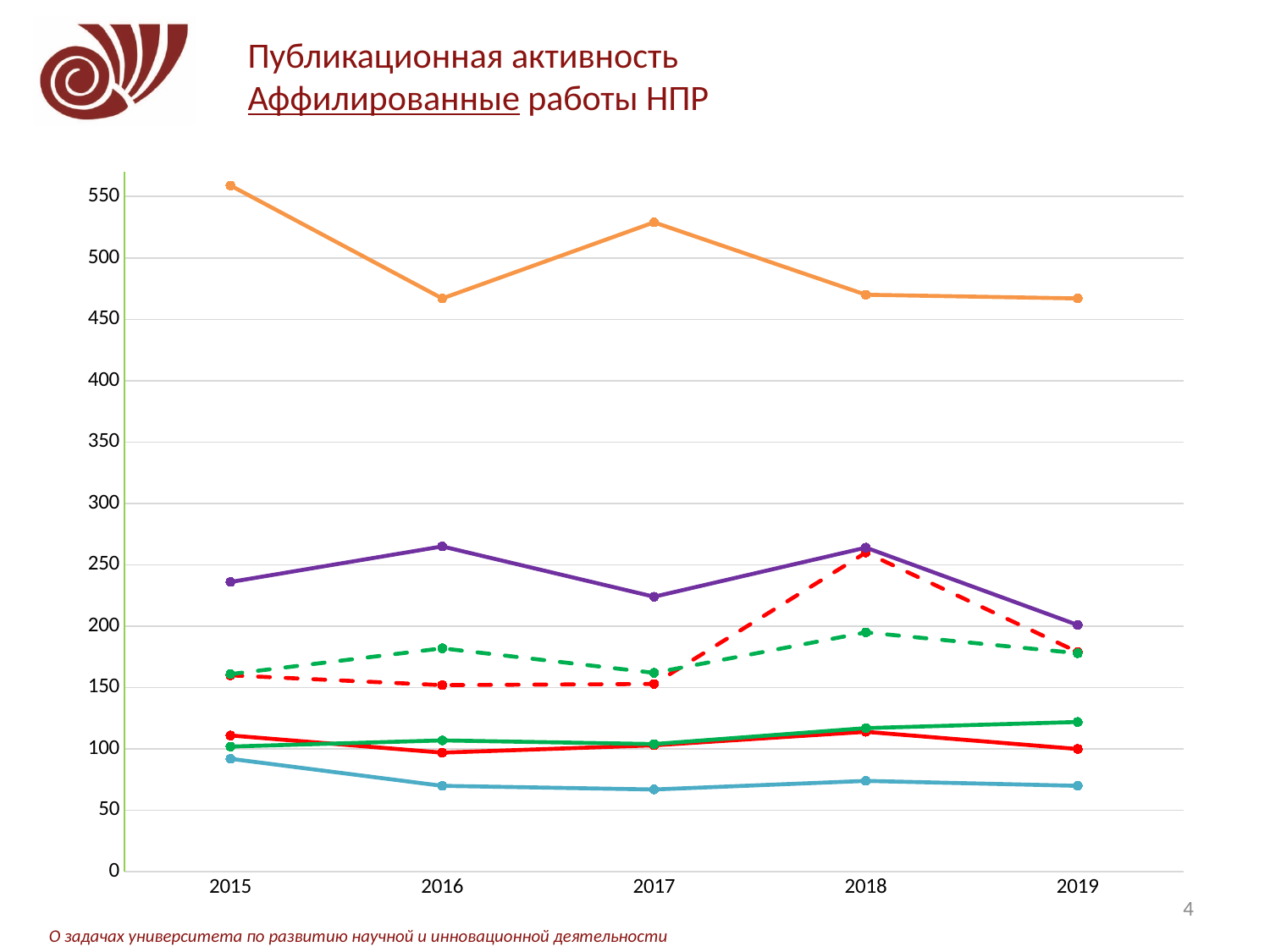
In which year does the red dashed line reach its highest value? 2018 What kind of chart is shown on the slide? line chart How many years are shown on the x axis of the chart? 5 In which year does the orange line reach its highest value? 2015 Is the value of the blue line in 2015 greater or less than 100? less Is the value of the orange line in 2016 greater or less than 500? less In which year does the purple line reach its lowest value? 2019 In 2017, which is larger: the purple line or the red dashed line? the purple line Which line has the highest values across all years? the orange line Is the value of the purple line in 2019 greater or less than 250? less Does the orange line rise or fall from 2015 to 2016? fall How many lines are plotted on the chart? 7